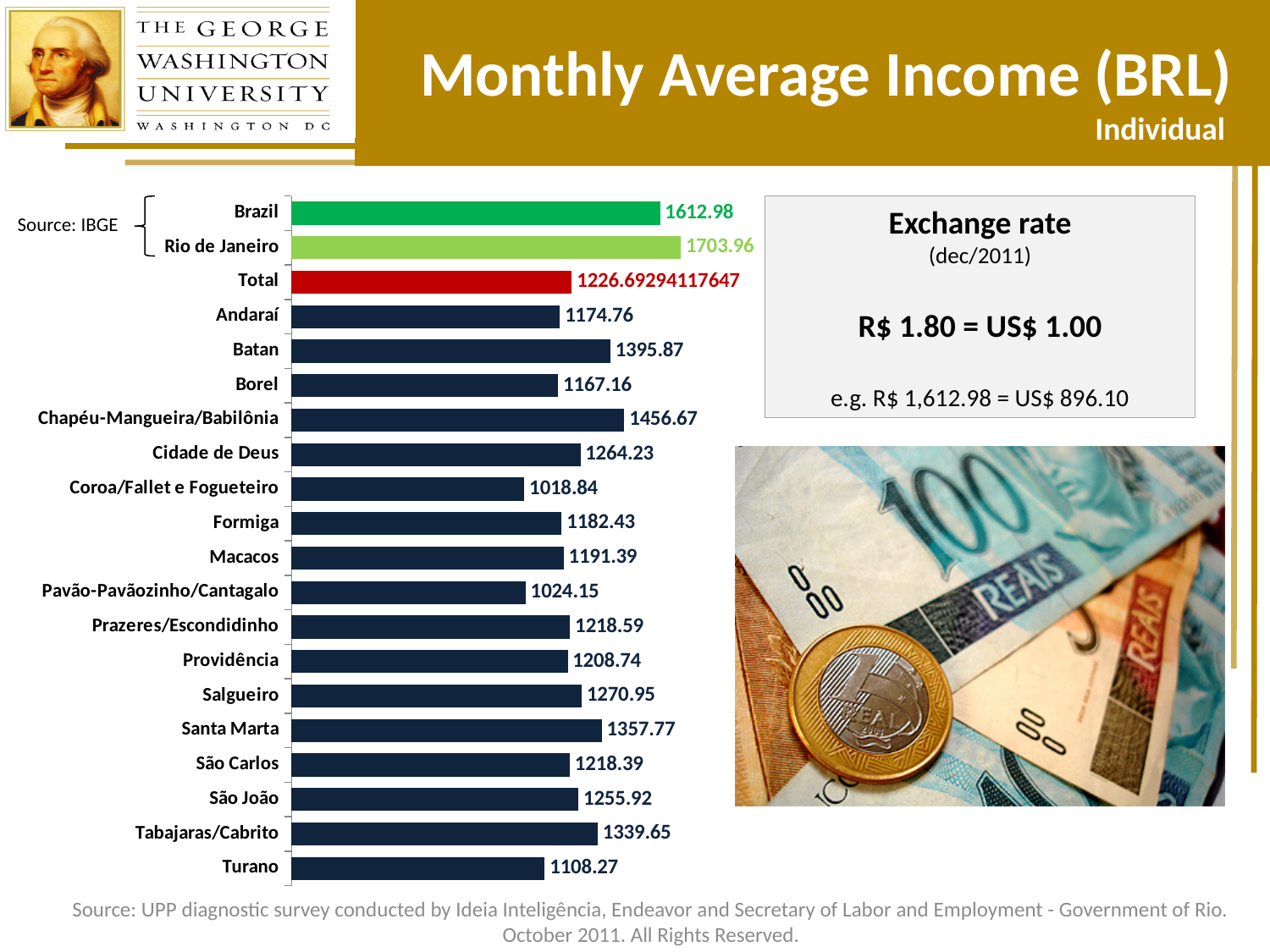
What is the monthly average income shown for Batan? 1395.87 How many categories (bars) are shown in the chart? 20 What is the difference between the values for Batan and Andaraí? 221.11 Which category has the highest value in the chart? Rio de Janeiro What colour is the Total bar in the chart? Red What is the value labelled for Rio de Janeiro? 1703.96 What is the difference between the values for Rio de Janeiro and Brazil? 90.98 What value is shown for the Total bar? 1226.69294117647 What kind of chart is shown on the slide? Bar chart Which category has the lowest value in the chart? Coroa/Fallet e Fogueteiro What value is shown for Chapéu-Mangueira/Babilônia? 1456.67 Which has a larger value, Tabajaras/Cabrito or São João? Tabajaras/Cabrito